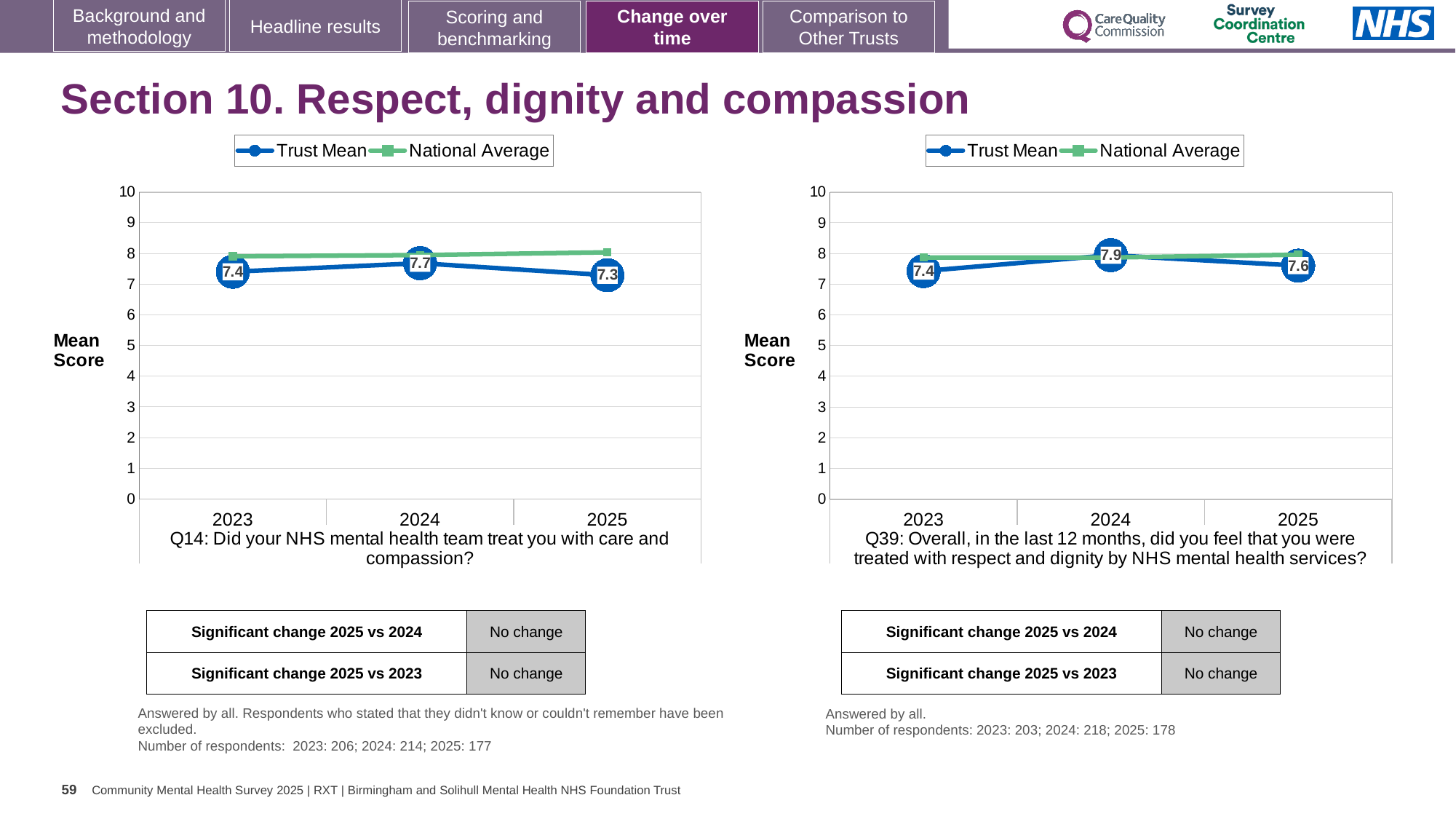
In the Q14 chart on the left, what is the Trust Mean score for 2024? 7.7 In the Q14 chart on the left, what is the difference between the Trust Mean scores for 2024 and 2025? 0.4 How many series does the legend of the Q39 chart on the right list? 2 How many years are plotted on the x axis of the Q14 chart on the left? 3 In the Q14 chart on the left, which is higher in 2025, the Trust Mean or the National Average? National Average In the Q39 chart on the right, what is the difference between the Trust Mean scores for 2023 and 2024? 0.5 In the Q39 chart on the right, which year has the highest Trust Mean score? 2024 In the Q14 chart on the left, does the Trust Mean rise or fall from 2024 to 2025? Fall In the Q39 chart on the right, is the National Average for 2023 greater or less than 7? greater What type of chart is the Q14 chart on the left? Line chart In the Q14 chart on the left, which year has the lowest Trust Mean score? 2025 In the Q39 chart on the right, what is the Trust Mean score for 2025? 7.6